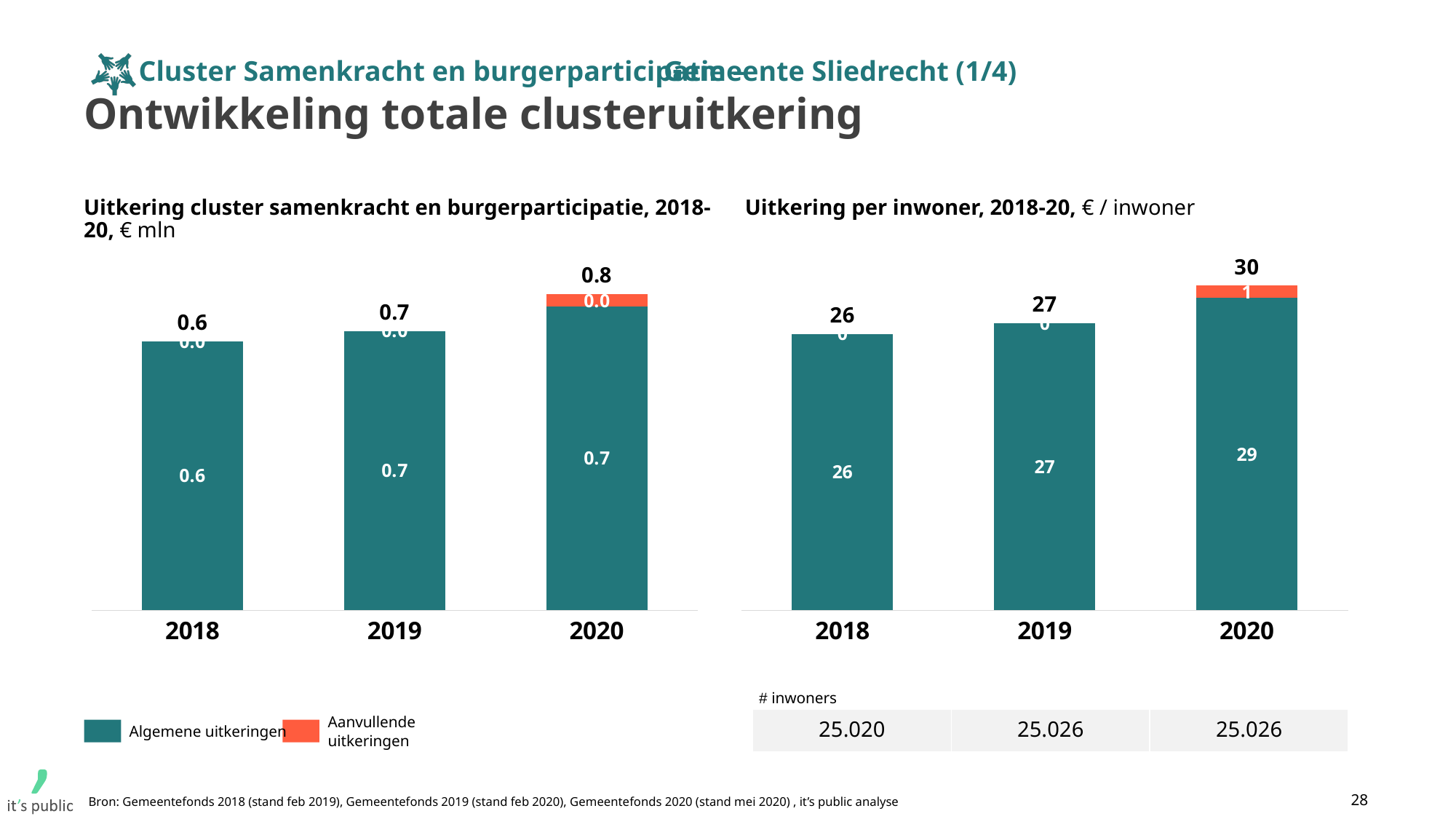
In the right chart (Uitkering per inwoner), do the totals rise or fall from 2018 to 2020? rise In the left chart (Uitkering cluster samenkracht en burgerparticipatie), which year has the highest total? 2020 What kind of chart is the right chart (Uitkering per inwoner)? stacked bar chart In the right chart (Uitkering per inwoner), what is the total value shown above the bar for 2020? 30 In the right chart (Uitkering per inwoner), what is the value of Algemene uitkeringen for 2020? 29 In the left chart (Uitkering cluster samenkracht en burgerparticipatie), which year has the lowest total? 2018 In the left chart (Uitkering cluster samenkracht en burgerparticipatie), what is the value of Algemene uitkeringen for 2019? 0.7 How many series does the legend list? 2 In the right chart (Uitkering per inwoner), what is the difference between the total for 2020 and the total for 2018? 4 How many years are shown on the x axis of the left chart (Uitkering cluster samenkracht en burgerparticipatie)? 3 In the left chart (Uitkering cluster samenkracht en burgerparticipatie), what is the total value shown above the bar for 2020? 0.8 In the right chart (Uitkering per inwoner), what is the value of Aanvullende uitkeringen for 2020? 1